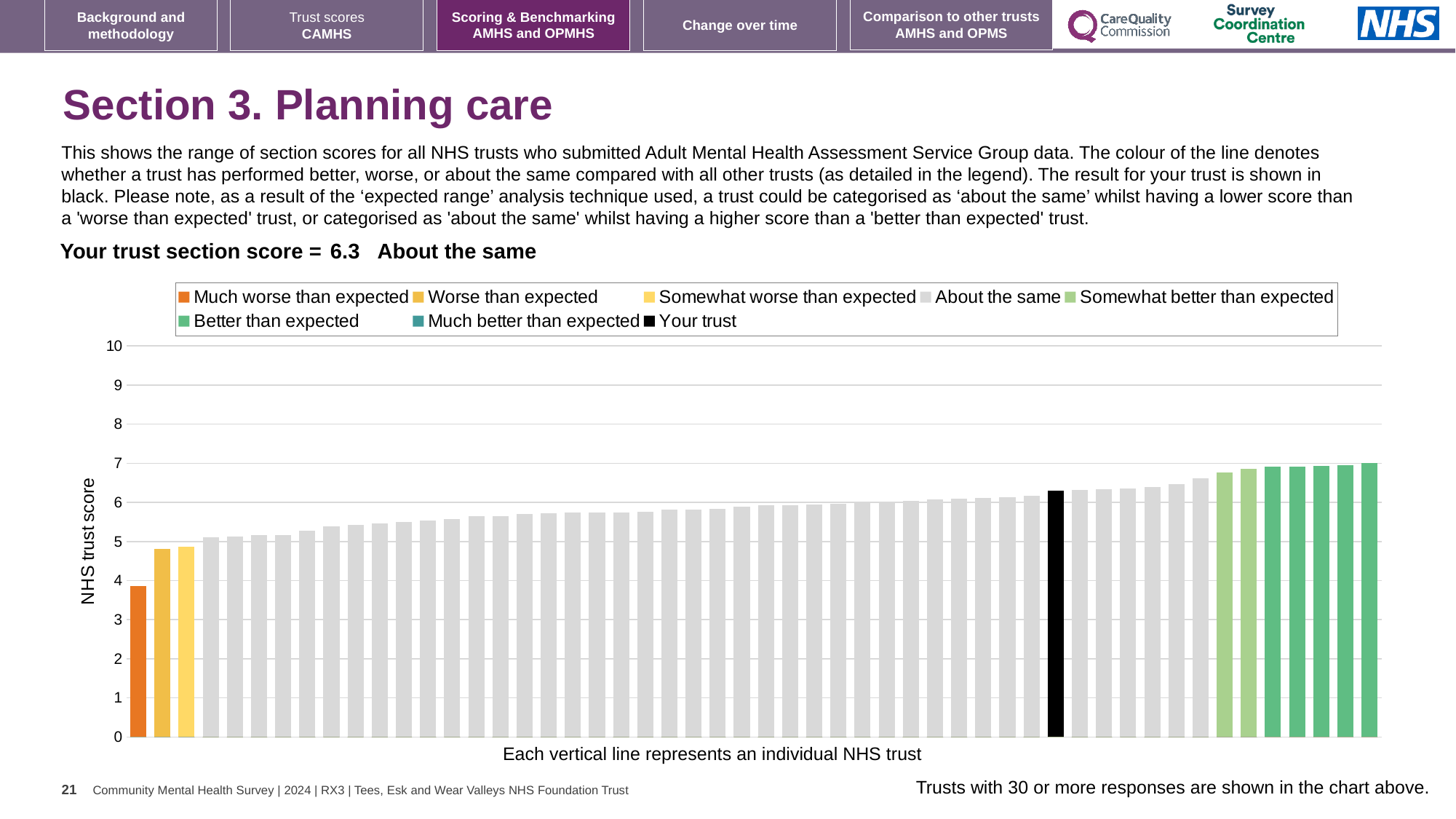
Which is higher, the 'Your trust' bar or the 'Much worse than expected' bar? Your trust How many entries does the chart legend list? 8 What kind of chart is shown on the slide? bar chart Which legend category contains the lowest bar in the chart? Much worse than expected Is the value for the 'Much worse than expected' bar greater or less than 4? less Do the bar values rise or fall from left to right along the x axis? rise Which legend category contains the highest bar in the chart? Better than expected What is your trust's section score for Planning care? 6.3 Is the value for the 'Your trust' bar greater or less than 6? greater What is the label on the vertical axis of the chart? NHS trust score How many bars are coloured as 'Better than expected'? 5 Which category is your trust placed in for Planning care? About the same